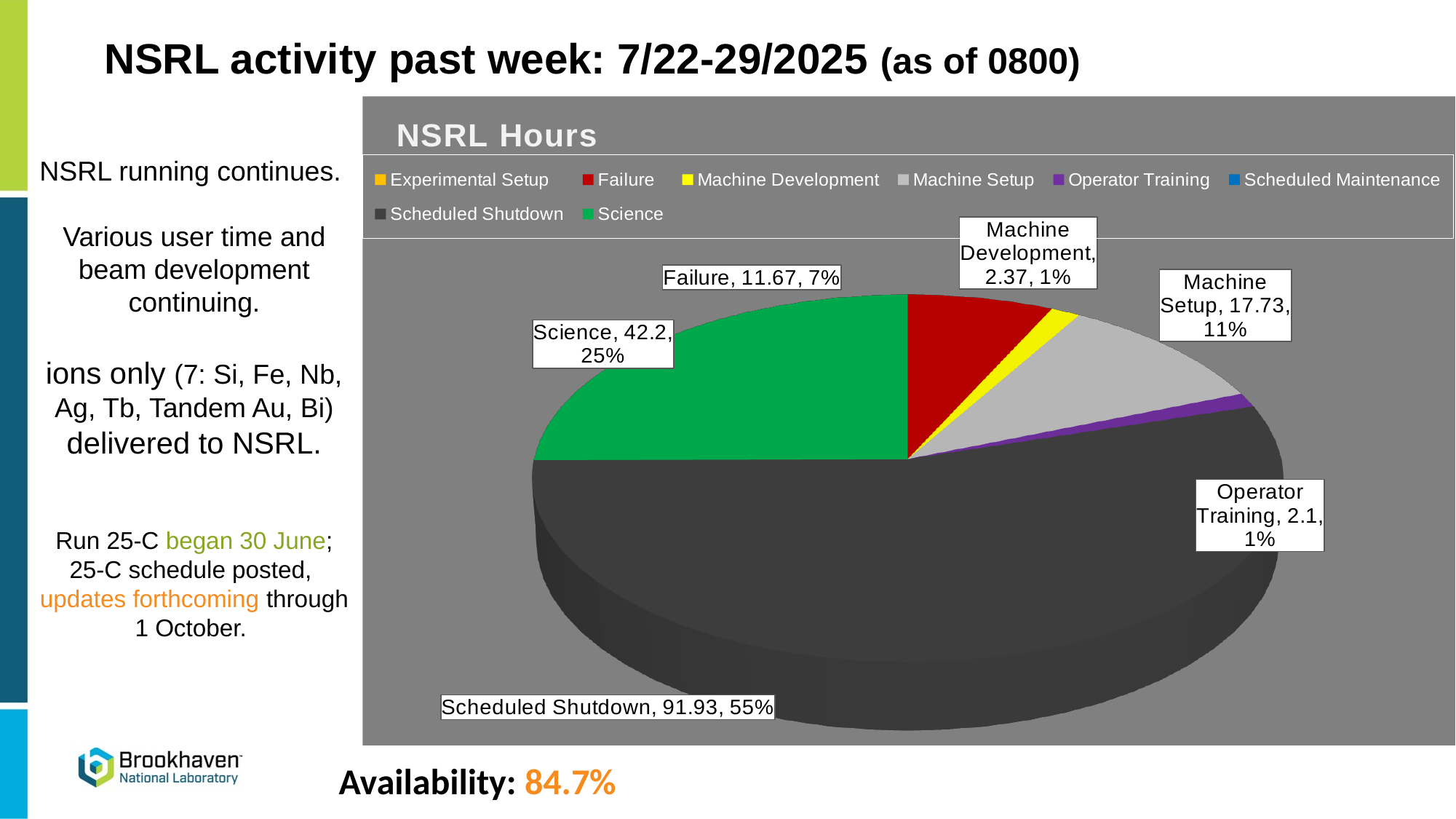
How many entries does the chart's legend list? 8 How many hours are shown for Machine Setup? 17.73 How many hours are shown for Scheduled Shutdown? 91.93 What kind of chart is shown on the slide? pie chart Which category has the largest slice of the pie? Scheduled Shutdown What colour is the Science slice in the pie chart? green How many hours are shown for Science? 42.2 Which has more hours, Failure or Machine Setup? Machine Setup What is the difference in hours between Science and Failure? 30.53 What is the title of the chart? NSRL Hours What percentage share of the pie does Scheduled Shutdown have? 55% What percentage share of the pie does Failure have? 7%